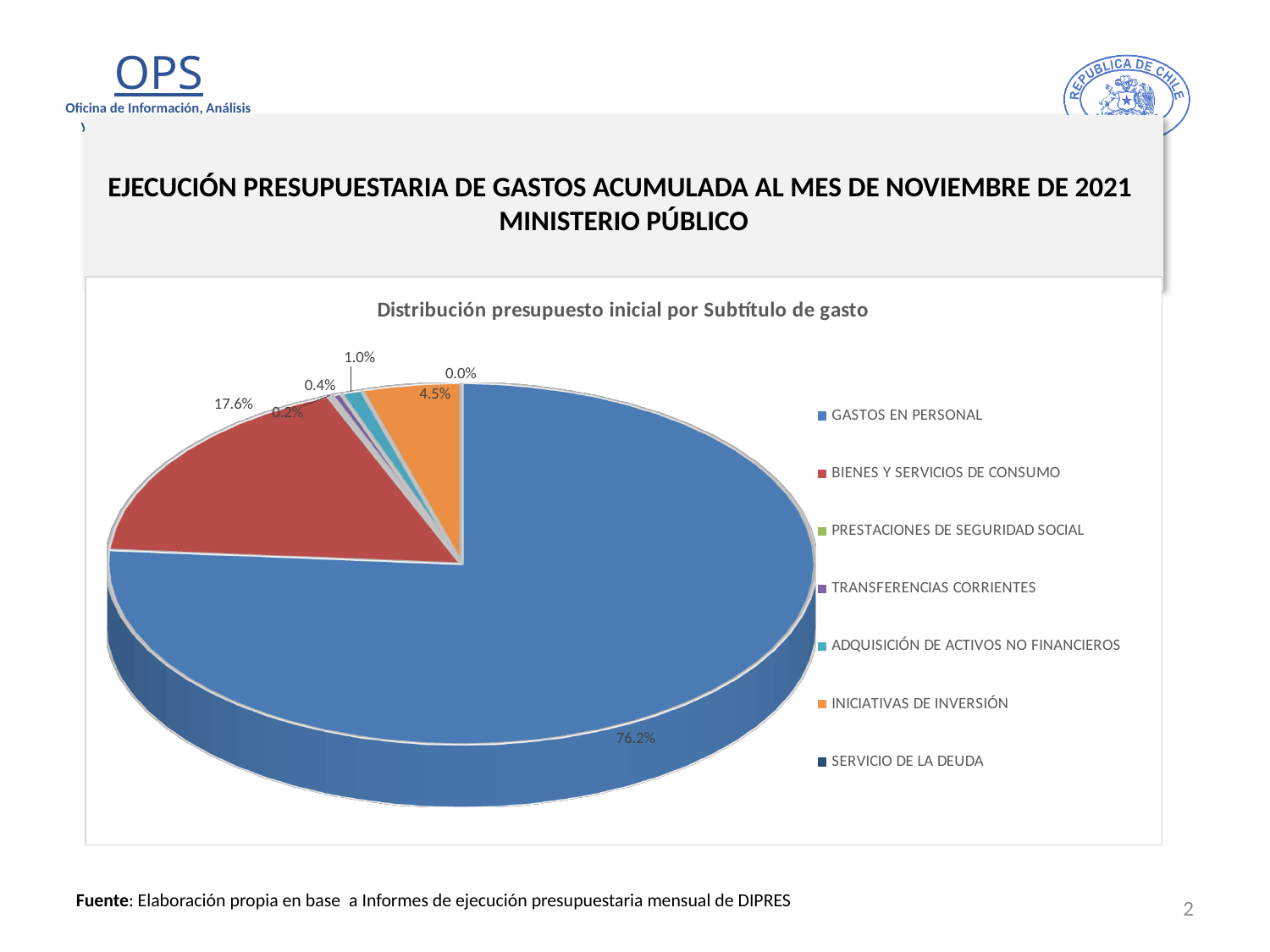
What share of the pie does GASTOS EN PERSONAL represent? 76.2% Which is larger, the share for BIENES Y SERVICIOS DE CONSUMO or the share for INICIATIVAS DE INVERSIÓN? BIENES Y SERVICIOS DE CONSUMO What is the difference in percentage points between GASTOS EN PERSONAL and BIENES Y SERVICIOS DE CONSUMO? 58.6 Which category has the largest share of the pie? GASTOS EN PERSONAL What kind of chart is shown on the slide? Pie chart How many categories does the legend of the pie chart list? 7 What share of the pie does SERVICIO DE LA DEUDA represent? 0.0% What share of the pie does INICIATIVAS DE INVERSIÓN represent? 4.5% Which category has the smallest share of the pie? SERVICIO DE LA DEUDA What is the title of the chart? Distribución presupuesto inicial por Subtítulo de gasto What share of the pie does ADQUISICIÓN DE ACTIVOS NO FINANCIEROS represent? 1.0% What share of the pie does BIENES Y SERVICIOS DE CONSUMO represent? 17.6%